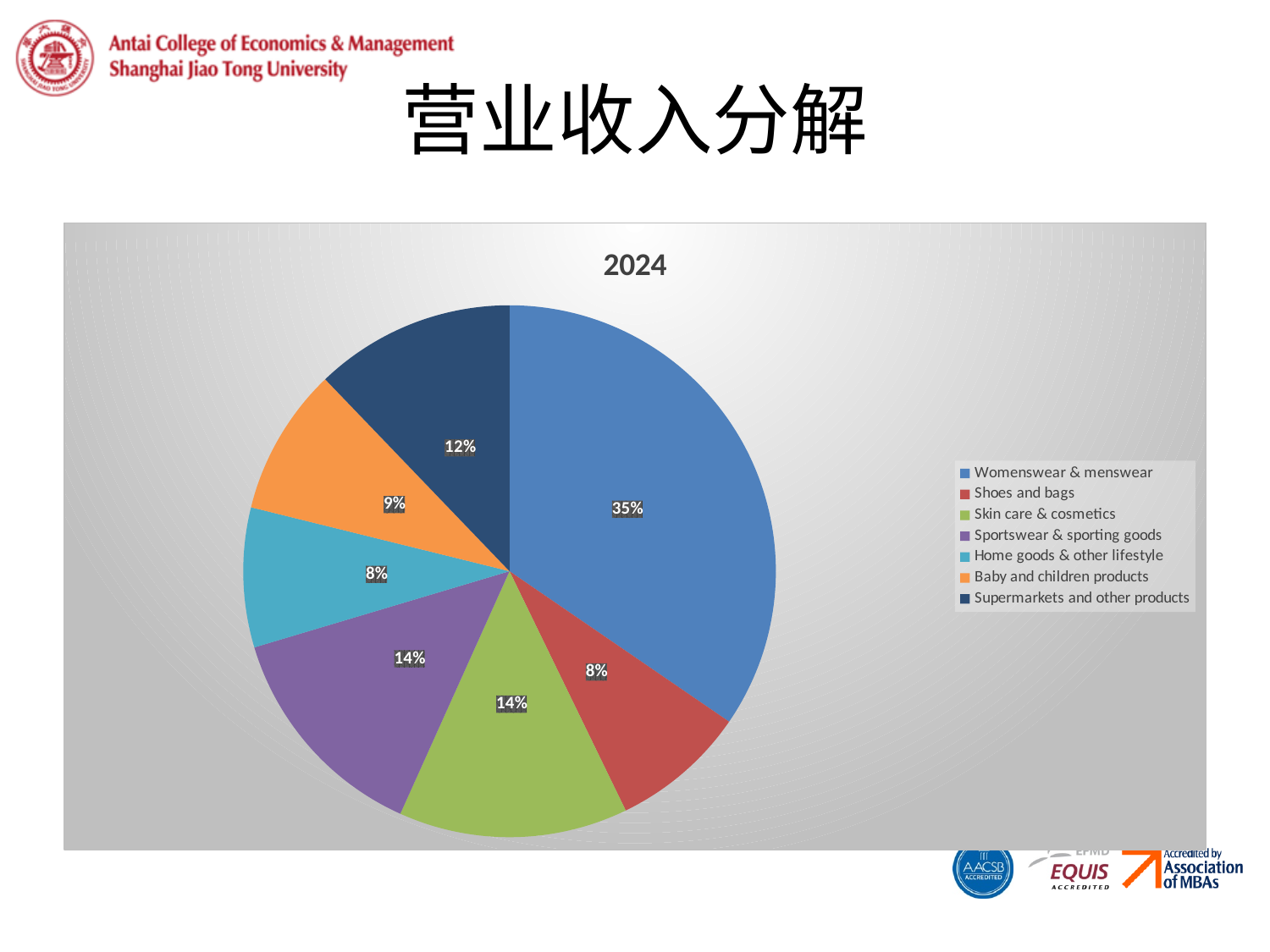
Which category has the largest slice of the pie? Womenswear & menswear What is the difference in percentage points between Womenswear & menswear and Supermarkets and other products? 23 What share of the pie is Baby and children products? 9% What share of the pie is Skin care & cosmetics? 14% What is the chart's title? 2024 What is the difference in percentage points between Sportswear & sporting goods and Shoes and bags? 6 How many categories does the legend list? 7 What share of the pie is Supermarkets and other products? 12% What kind of chart is shown on the slide? Pie chart Which is larger, the share for Baby and children products or the share for Home goods & other lifestyle? Baby and children products What colour is the slice for Womenswear & menswear? Blue